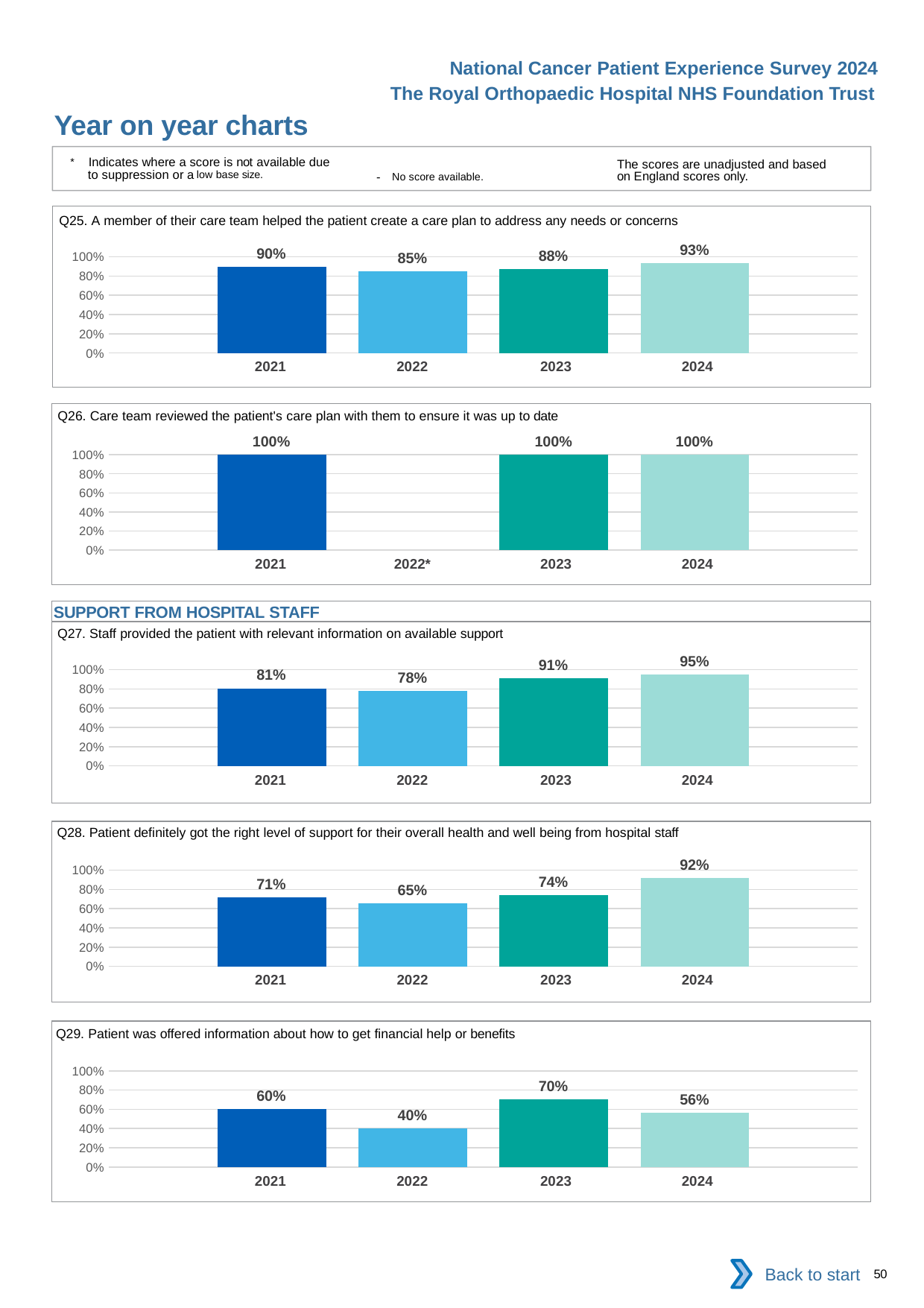
In the Q27 chart, what is the difference between the 2024 and 2021 values? 14% In the Q28 chart, what is the value for 2022? 65% In the Q29 chart, which year has the lowest value? 2022 In the Q26 chart, what is the value for 2023? 100% In the Q29 chart, what is the difference between the 2023 and 2024 values? 14% How many years are shown on the x axis of the Q29 chart? 4 In the Q28 chart, is the value for 2023 larger than the value for 2021? Yes In the Q25 chart, which year has the lowest value? 2022 In the Q27 chart, which year has the highest value? 2024 In the Q25 chart, what is the value for 2024? 93% What type of chart is used for Q28? Bar chart In the Q26 chart, which year has no score shown? 2022*